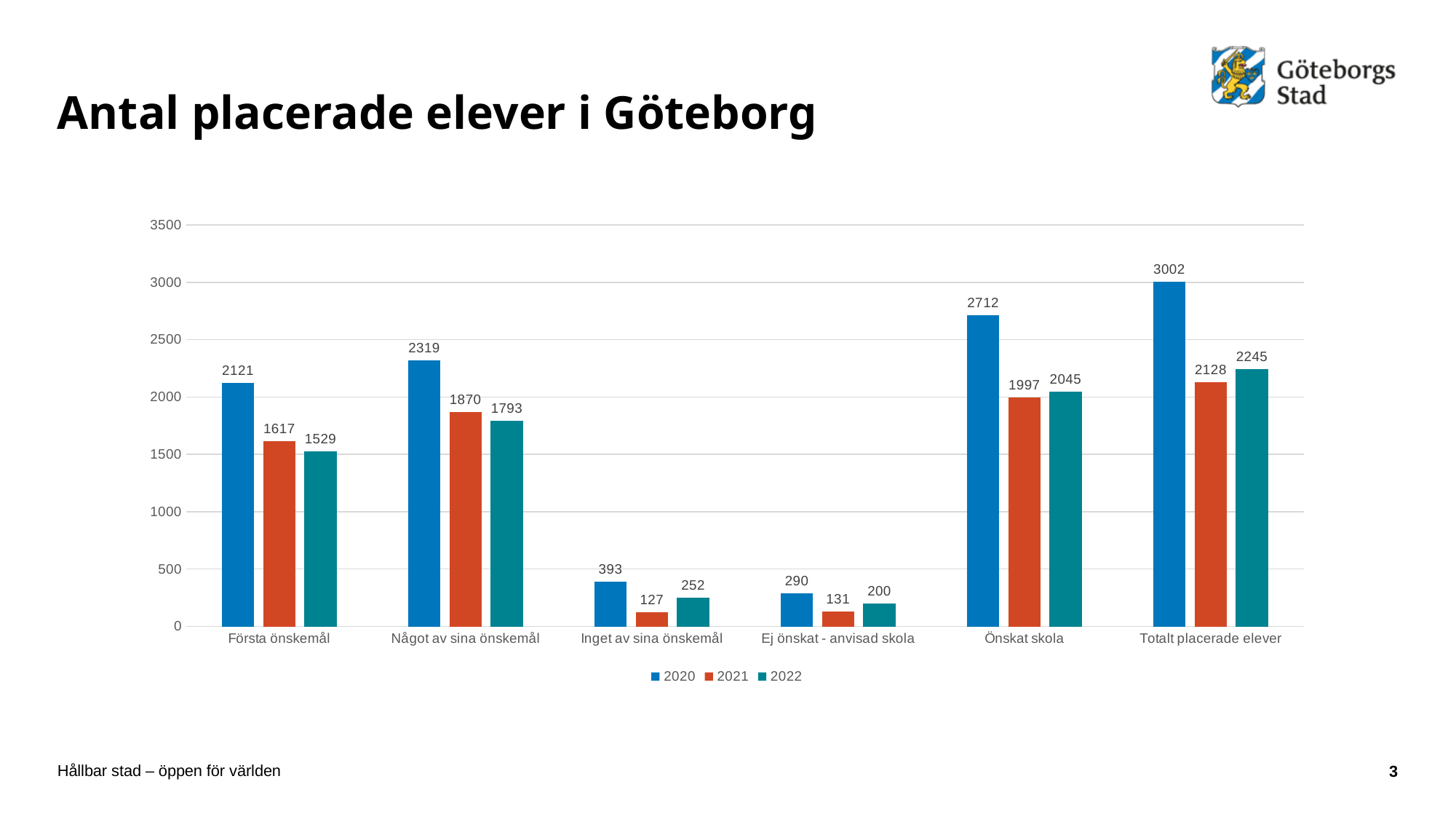
What is the value for 2021 in the 'Inget av sina önskemål' category? 127 What kind of chart is shown on the slide? bar chart How many categories are shown on the x axis? 6 How many series does the legend list? 3 Is the 2022 value for 'Första önskemål' greater or less than 2000? less What is the title of the slide? Antal placerade elever i Göteborg What is the difference between the 2020 and 2021 values for 'Önskat skola'? 715 Which category has the lowest value for the 2022 series? Ej önskat - anvisad skola What is the value for 2020 in the 'Första önskemål' category? 2121 What is the value for 2022 in the 'Totalt placerade elever' category? 2245 Which category has the highest value for the 2020 series? Totalt placerade elever Which is larger in the 'Något av sina önskemål' category: the 2021 value or the 2022 value? 2021